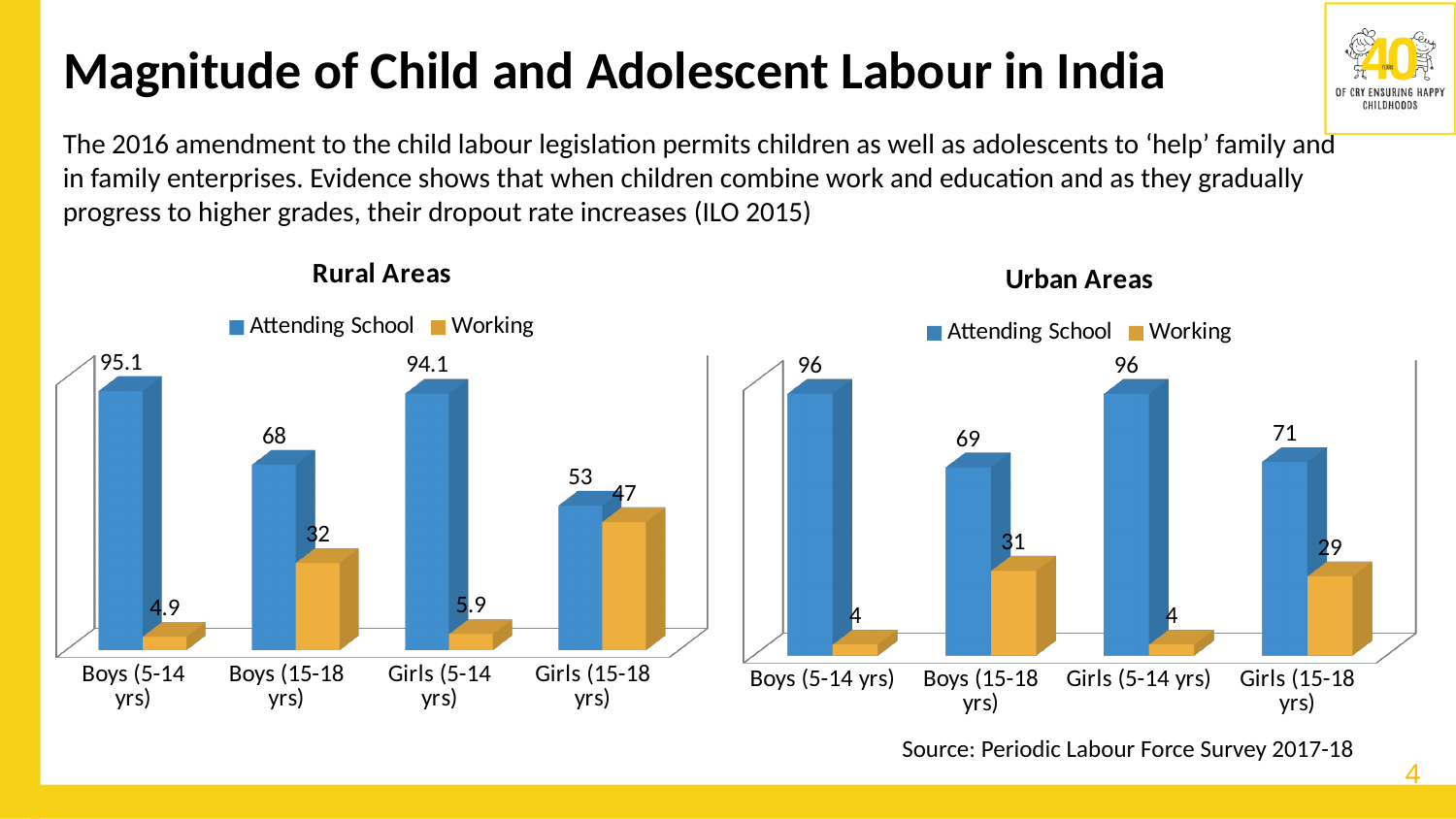
In the Urban Areas chart, what is the Attending School value for Girls (15-18 yrs)? 71 In the Urban Areas chart, what is the difference between the Working values for Boys (15-18 yrs) and Boys (5-14 yrs)? 27 In the Rural Areas chart, what is the Attending School value for Boys (5-14 yrs)? 95.1 In the Urban Areas chart, which category has the highest Working value? Boys (15-18 yrs) In the Rural Areas chart, is the Working value for Boys (15-18 yrs) larger or smaller than the Working value for Girls (15-18 yrs)? smaller How many series does the legend of the Rural Areas chart list? 2 What kind of chart is the Urban Areas chart? bar chart In the Rural Areas chart, what is the difference between the Attending School values for Boys (15-18 yrs) and Girls (15-18 yrs)? 15 How many categories are shown on the x axis of the Urban Areas chart? 4 In the Urban Areas chart, what is the Working value for Boys (15-18 yrs)? 31 In the Rural Areas chart, what is the Working value for Girls (15-18 yrs)? 47 In the Rural Areas chart, which category has the lowest Attending School value? Girls (15-18 yrs)